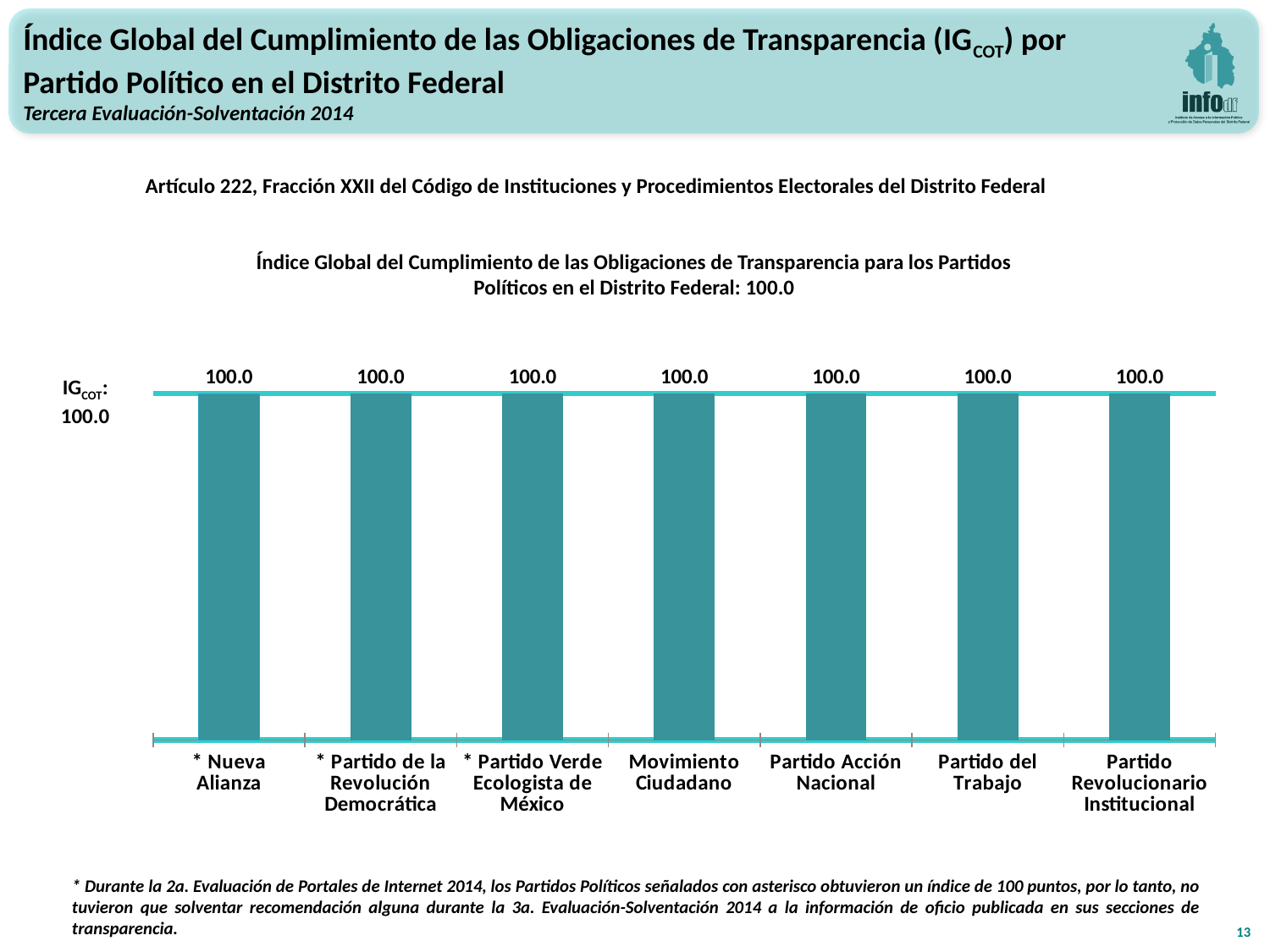
What kind of chart is shown on the slide? Bar chart What is the IGCOT value for Partido Acción Nacional? 100.0 Which party is shown in the rightmost bar of the chart? Partido Revolucionario Institucional What is the IGCOT value for Partido del Trabajo? 100.0 What is the IGCOT value for Movimiento Ciudadano? 100.0 What is the overall Índice Global del Cumplimiento de las Obligaciones de Transparencia for the political parties in the Distrito Federal stated above the chart? 100.0 What is the IGCOT value for Nueva Alianza? 100.0 What is the IGCOT value for Partido Revolucionario Institucional? 100.0 How many political parties are shown in the chart? 7 What is the difference between the IGCOT values of Partido Verde Ecologista de México and Partido de la Revolución Democrática? 0.0 Do the IGCOT values rise, fall, or stay flat across the parties from left to right? Stay flat